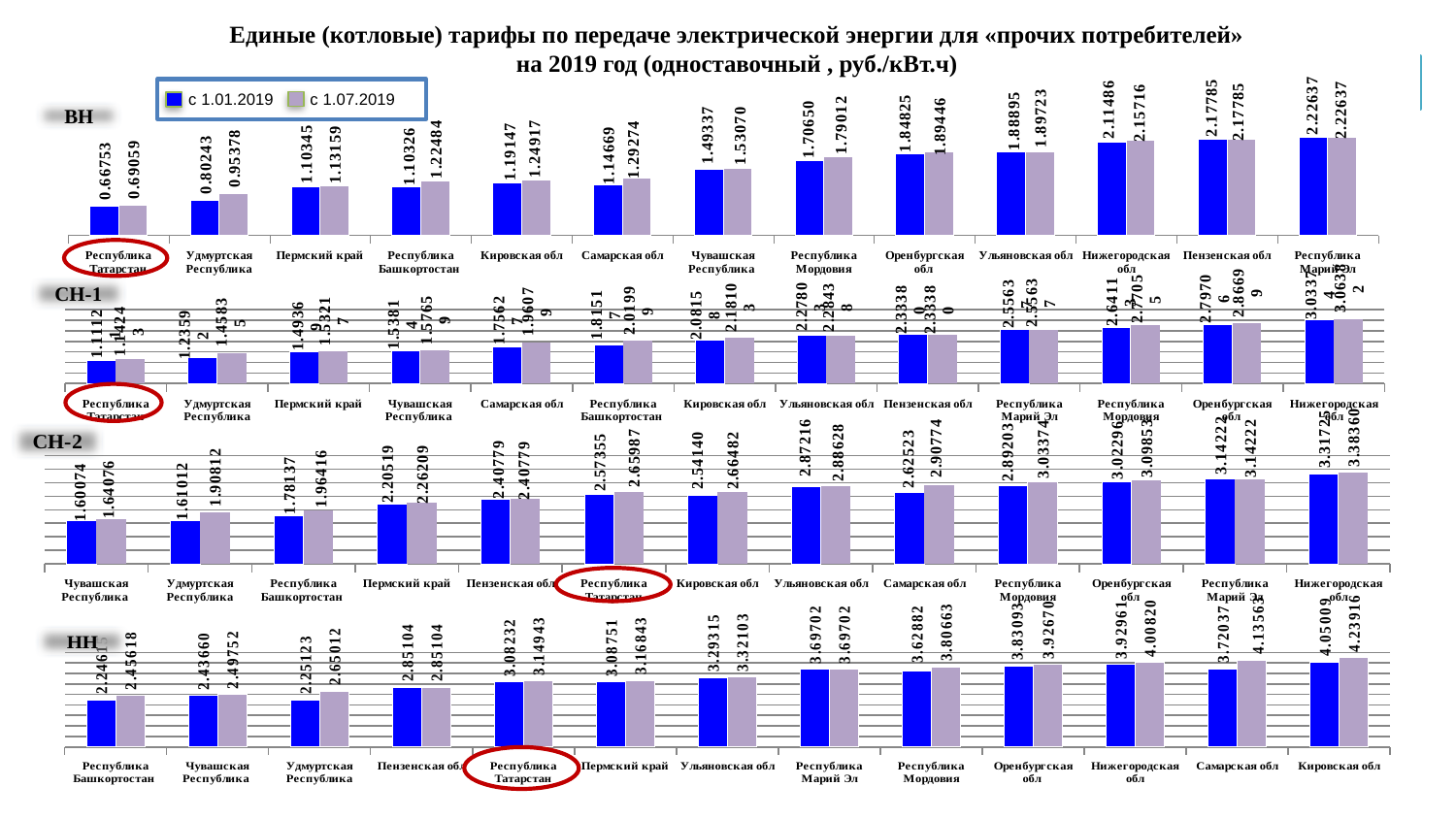
How many regions are shown in the ВН chart? 13 In the ВН chart, what is the value for Республика Татарстан for the series с 1.01.2019? 0.66753 In the СН-2 chart, which is larger for с 1.07.2019: Удмуртская Республика or Пермский край? Пермский край In the ВН chart, what is the difference between the с 1.07.2019 and с 1.01.2019 values for Республика Татарстан? 0.02306 In the ВН chart, which region has the lowest value for с 1.01.2019? Республика Татарстан In the НН chart, what is the difference between the с 1.07.2019 and с 1.01.2019 values for Самарская обл? 0.41526 In the ВН chart, which region has the highest value for с 1.07.2019? Республика Марий Эл What type of chart is the ВН chart? Bar chart In the ВН chart, what is the value for Удмуртская Республика for the series с 1.07.2019? 0.95378 In the НН chart, what is the value for Кировская обл for the series с 1.07.2019? 4.23916 How many series does the legend list? 2 In the СН-2 chart, what is the value for Нижегородская обл for the series с 1.01.2019? 3.31725